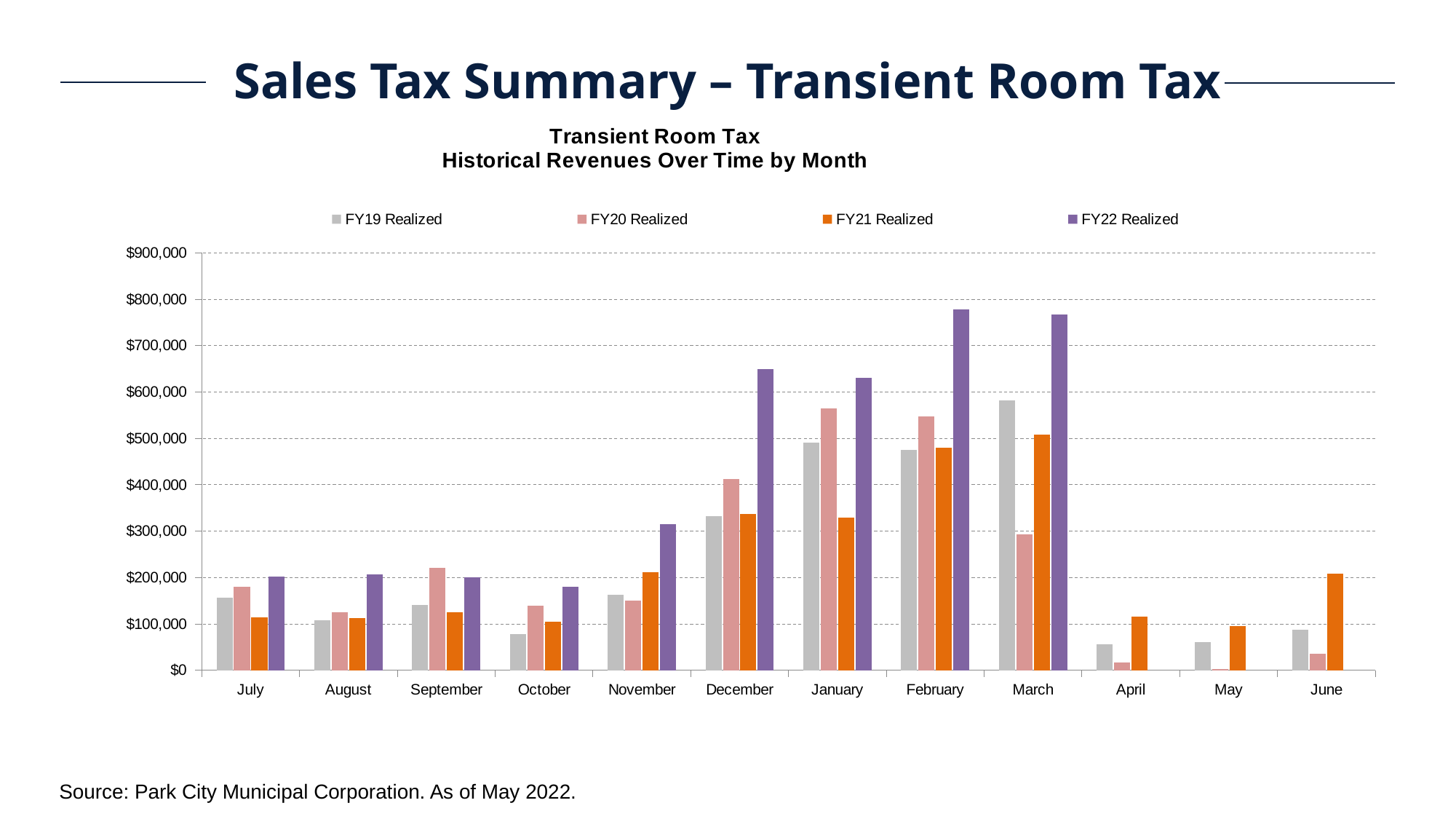
What kind of chart is shown on the slide? Bar chart Which month has the lowest FY20 Realized value? May Which series has no bars for April, May and June? FY22 Realized In December, which is larger: FY22 Realized or FY20 Realized? FY22 Realized Is the FY22 Realized value for December greater or less than $600,000? greater How many series does the legend list? 4 Do the FY22 Realized values rise or fall from November to February? Rise In March, which is larger: FY19 Realized or FY20 Realized? FY19 Realized Is the FY19 Realized value for October greater or less than $100,000? less Is the FY22 Realized value for February greater or less than $700,000? greater How many months are shown on the x axis? 12 Which month has the highest FY19 Realized value? March